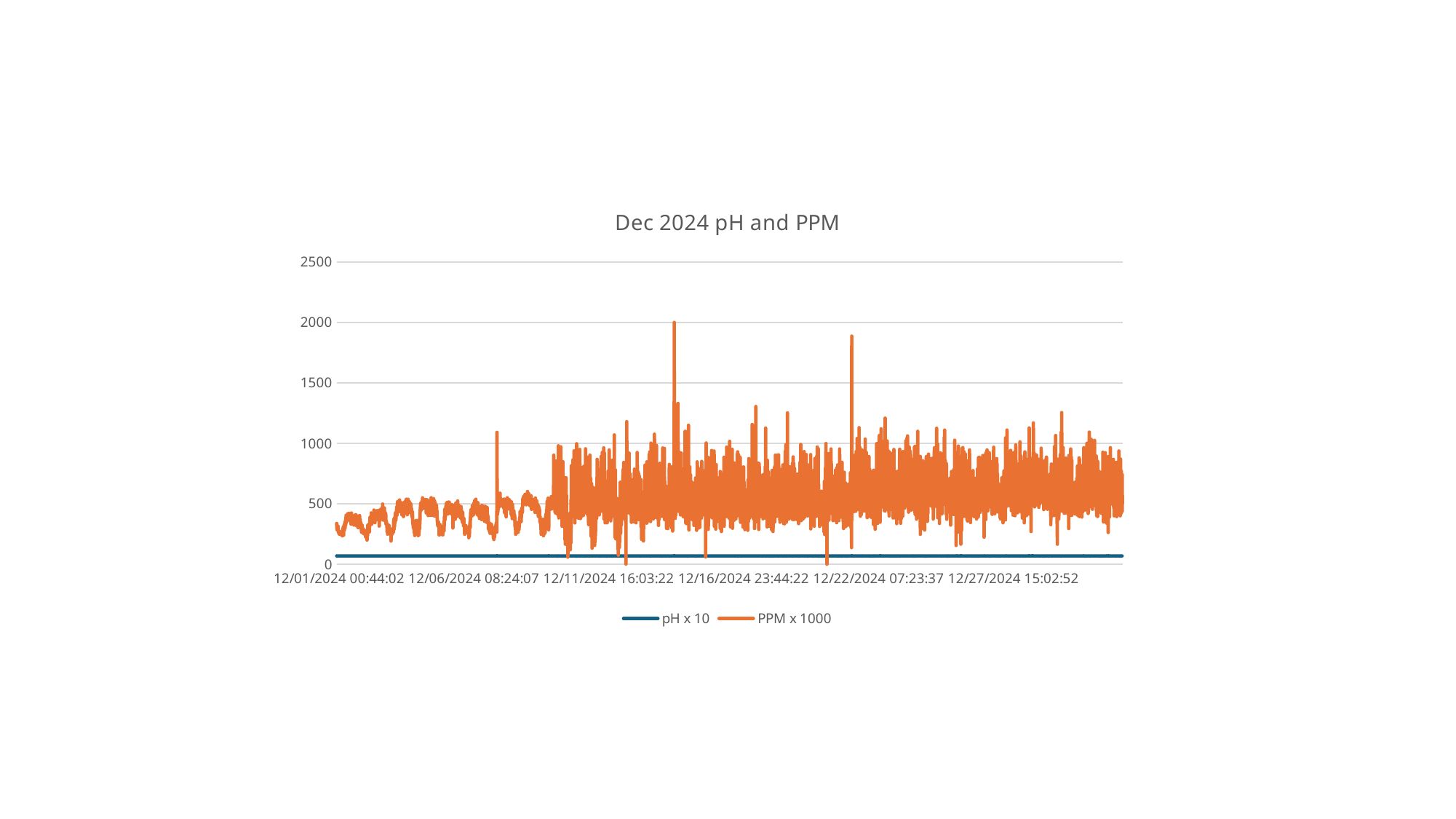
Is the value of the pH x 10 series greater or less than 500 throughout the chart? less Is the highest peak of the PPM x 1000 series greater or less than 1500? greater What kind of chart is shown on the slide? line chart What is the title of the chart? Dec 2024 pH and PPM Is the value of the PPM x 1000 series at the start of the chart (12/01/2024) greater or less than 1000? less How many series does the legend list? 2 Which series is drawn in orange? PPM x 1000 What is the highest value shown on the vertical axis? 2500 Does the PPM x 1000 series generally rise or fall from the start of December to the end? rise Which series has the higher values across the chart, pH x 10 or PPM x 1000? PPM x 1000